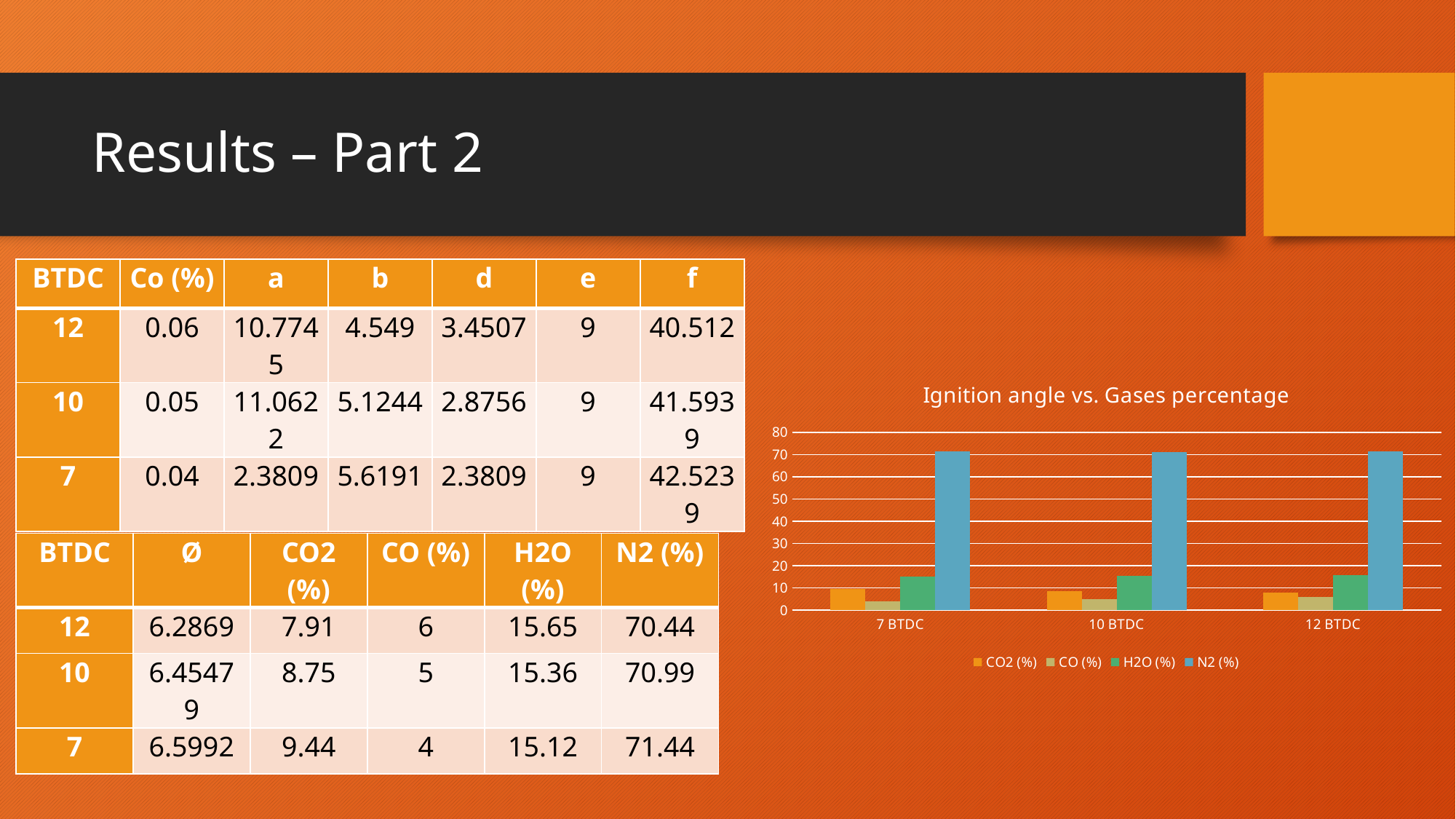
At 7 BTDC, which is larger: the N2 (%) bar or the H2O (%) bar? N2 (%) Which series has the tallest bar at 12 BTDC? N2 (%) At 10 BTDC, which is larger: the CO2 (%) bar or the CO (%) bar? CO2 (%) What is the title of the chart? Ignition angle vs. Gases percentage How many categories are shown on the x axis of the chart? 3 Is the N2 (%) value at 7 BTDC greater or less than 60? greater Which series is drawn in blue in the chart? N2 (%) Which series has the shortest bar at 10 BTDC? CO (%) Is the H2O (%) value at 10 BTDC greater or less than 20? less Is the CO (%) value at 12 BTDC greater or less than 10? less How many series does the chart legend list? 4 What type of chart is shown on the slide? bar chart